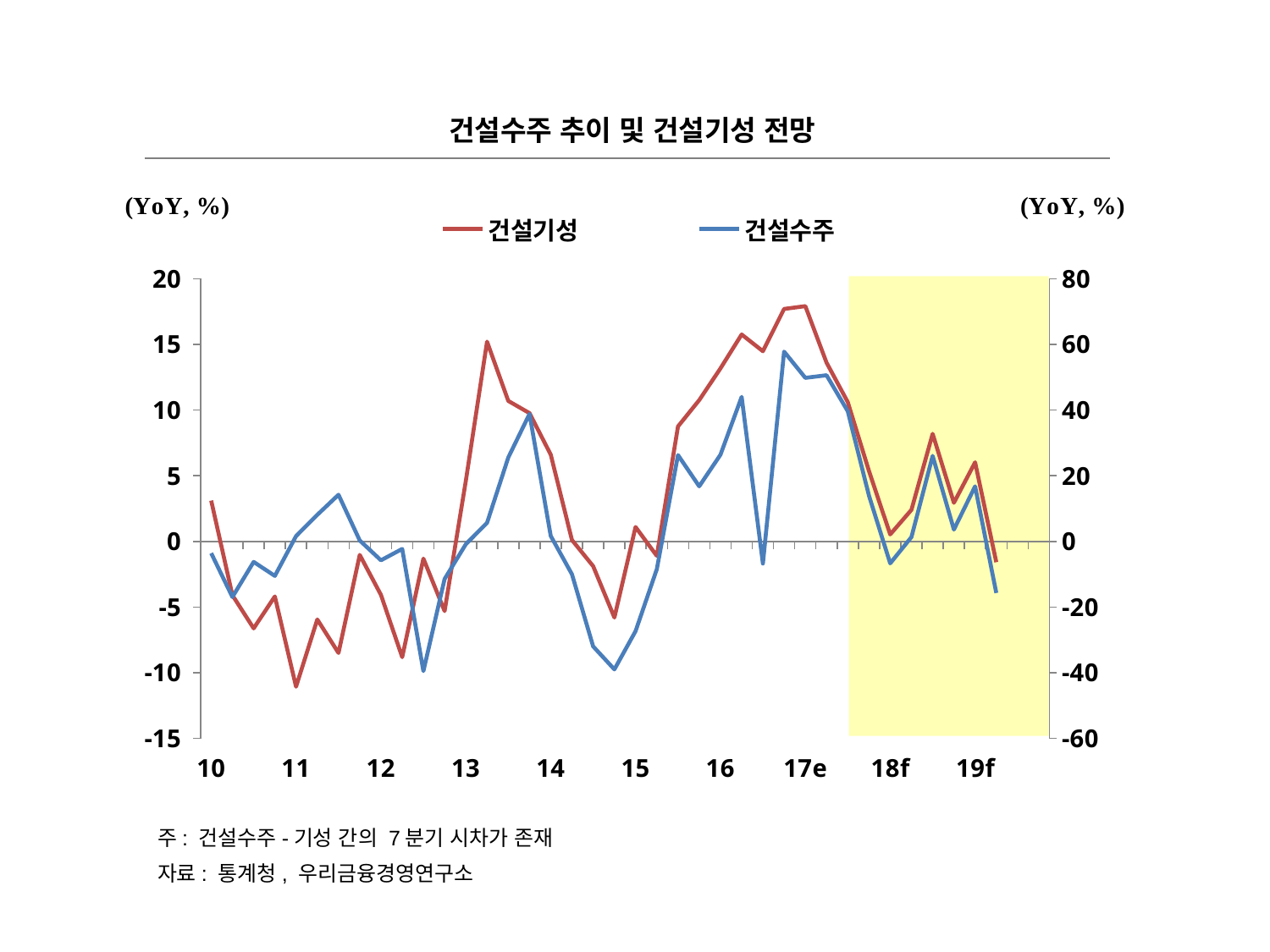
How many series does the legend list? 2 What kind of chart is shown on the slide? line chart What are the two series named in the legend? 건설기성, 건설수주 Is the lowest value of 건설수주 around 15 greater or less than -20 on the right axis? less Is the peak value of 건설수주 around 17e greater or less than 40 on the right axis? greater Does the 건설기성 line rise or fall between 17e and 18f? fall What is the title of the chart? 건설수주 추이 및 건설기성 전망 Is the peak value of 건설기성 around 17e greater or less than 15 on the left axis? greater Does the 건설기성 line rise or fall between 15 and 17e? rise How many year labels are shown on the x axis? 10